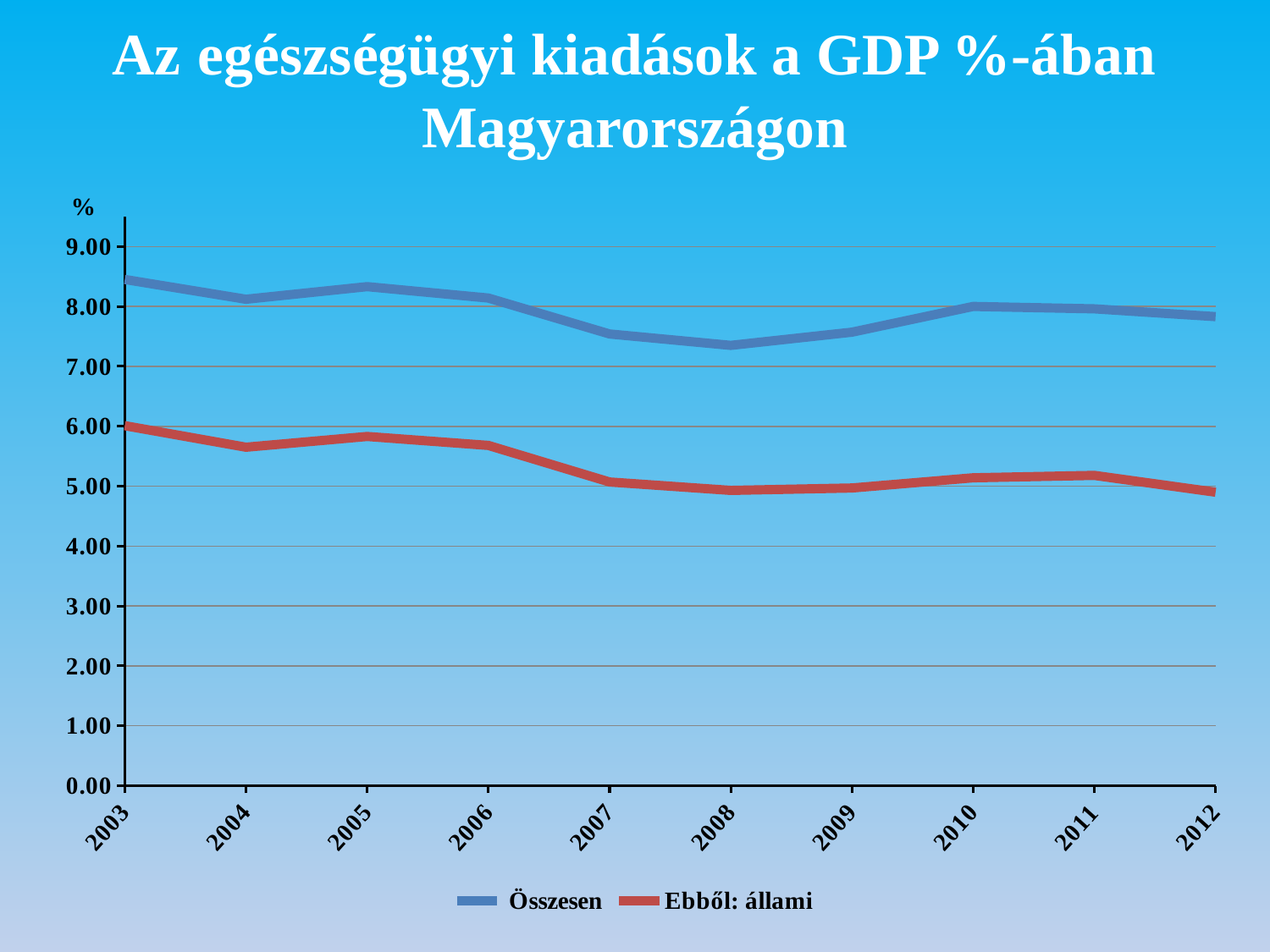
What kind of chart is shown on the slide? line chart How many series does the legend list? 2 What is the title of the chart? Az egészségügyi kiadások a GDP %-ában Magyarországon Which series is drawn in red? Ebből: állami Is the value for Összesen in 2010 greater or less than 7.00? greater In 2007, which series has the larger value, Összesen or Ebből: állami? Összesen Is the value for Összesen in 2003 greater or less than 8.00? greater How many years are plotted along the x axis? 10 In which year is the Ebből: állami series at its highest? 2003 In which year is the Összesen series at its lowest? 2008 Is the value for Összesen in 2008 greater or less than 8.00? less